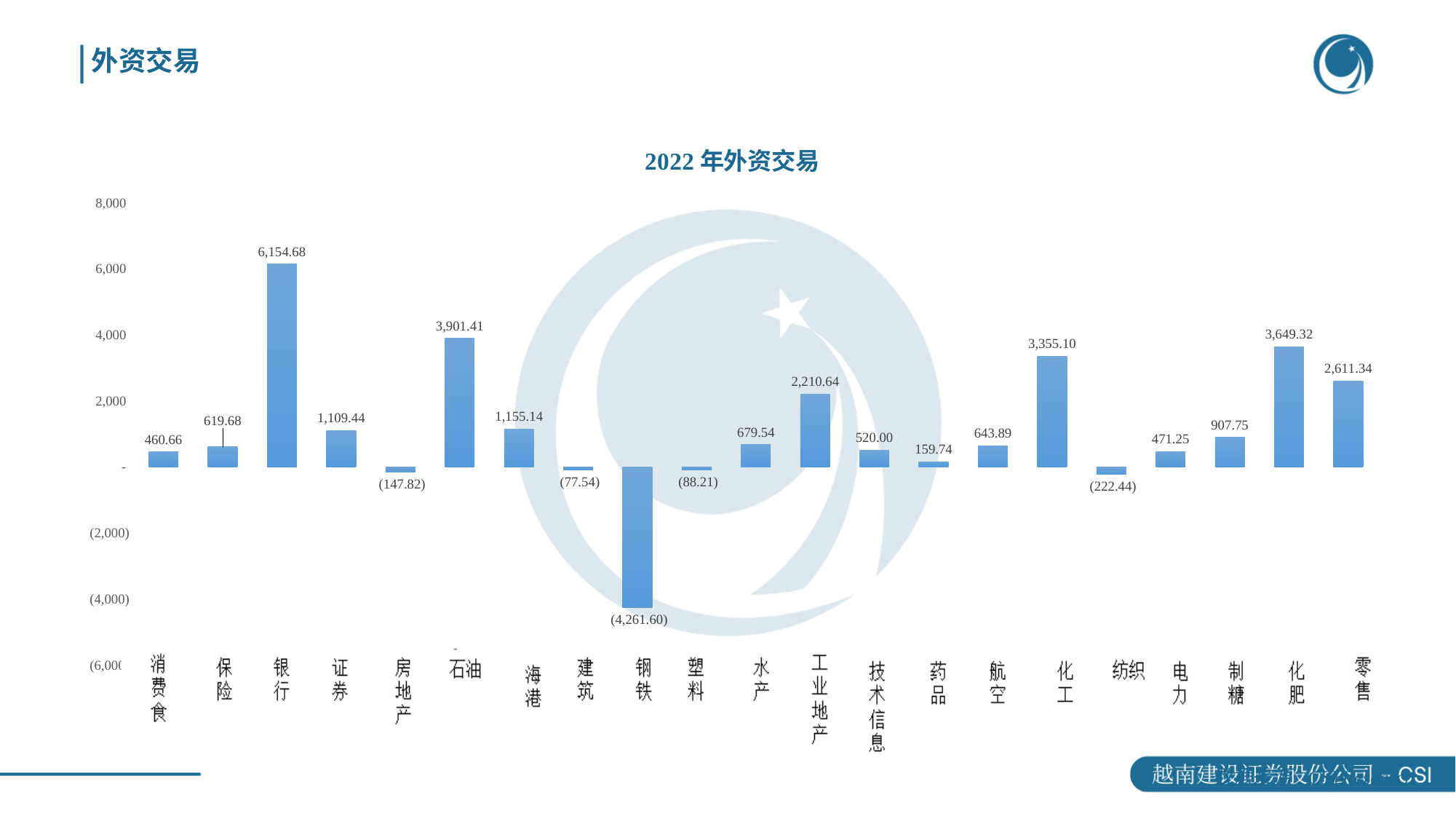
What is the value for 纺织 in the 2022 年外资交易 chart? (222.44) Is the value for 化工 greater or less than 2,000 in the 2022 年外资交易 chart? greater What is the difference between the values for 石油 and 化工 in the 2022 年外资交易 chart? 546.31 Which category has the lowest value in the 2022 年外资交易 chart? 钢铁 What is the value for 化肥 in the 2022 年外资交易 chart? 3,649.32 What is the value for 钢铁 in the 2022 年外资交易 chart? (4,261.60) How many categories are shown in the 2022 年外资交易 chart? 21 Which category has the highest value in the 2022 年外资交易 chart? 银行 What is the value for 银行 in the 2022 年外资交易 chart? 6,154.68 What is the title of the chart on the slide? 2022 年外资交易 What kind of chart is the 2022 年外资交易 chart? bar chart Which is larger in the 2022 年外资交易 chart, the value for 工业地产 or the value for 零售? 零售